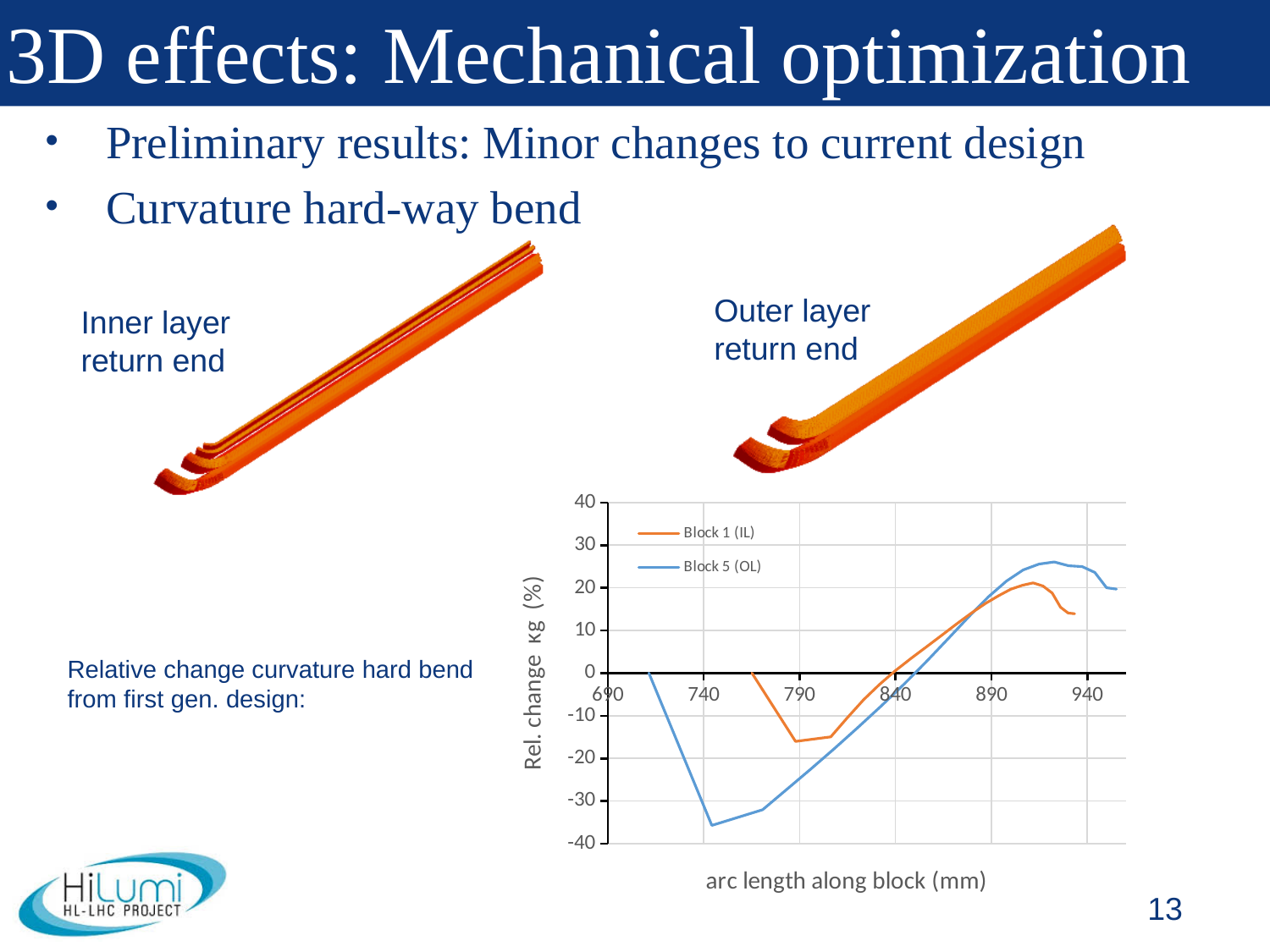
What are the two series named in the chart legend? Block 1 (IL) and Block 5 (OL) At an arc length of 790 mm, which series has the higher value, Block 1 (IL) or Block 5 (OL)? Block 1 (IL) Is the highest value of the Block 5 (OL) series greater or less than 20? greater Is the highest value of the Block 1 (IL) series greater or less than 30? less Which series reaches the lower minimum value, Block 1 (IL) or Block 5 (OL)? Block 5 (OL) What is the label of the x axis of the chart? arc length along block (mm) Between arc lengths of 750 mm and 890 mm, does the Block 5 (OL) series rise or fall? rise Is the lowest value of the Block 1 (IL) series greater or less than -10? less What kind of chart is shown on the slide? line chart How many series does the chart legend list? 2